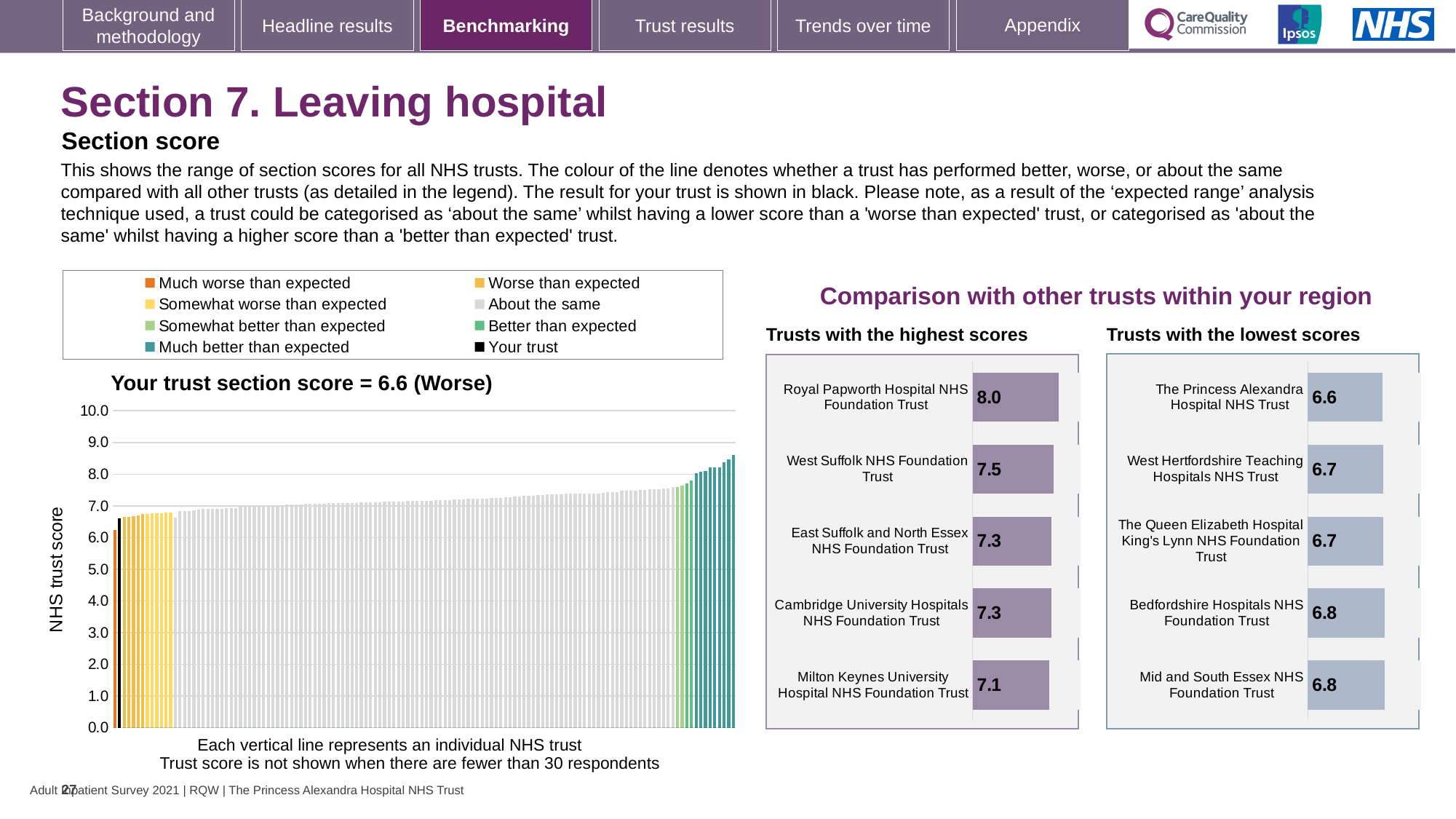
How many entries does the legend above the 'Your trust section score' chart list? 8 In the chart titled 'Your trust section score = 6.6 (Worse)', is the value of the tallest bar greater or less than 8.0? greater In the 'Trusts with the lowest scores' chart, which trust has the lowest score? The Princess Alexandra Hospital NHS Trust In the 'Trusts with the highest scores' chart, which trust has the highest score? Royal Papworth Hospital NHS Foundation Trust In the chart titled 'Your trust section score = 6.6 (Worse)', what kind of chart is shown? Bar chart In the 'Trusts with the highest scores' chart, what is the score for Royal Papworth Hospital NHS Foundation Trust? 8.0 In the 'Trusts with the lowest scores' chart, which has the larger score: West Hertfordshire Teaching Hospitals NHS Trust or Mid and South Essex NHS Foundation Trust? Mid and South Essex NHS Foundation Trust In the 'Trusts with the lowest scores' chart, what is the score for Bedfordshire Hospitals NHS Foundation Trust? 6.8 In the chart titled 'Your trust section score = 6.6 (Worse)', what is the label on the vertical axis? NHS trust score In the 'Trusts with the highest scores' chart, how many trusts are shown? 5 In the chart titled 'Your trust section score = 6.6 (Worse)', what is the section score for your trust? 6.6 In the 'Trusts with the highest scores' chart, what is the difference between the scores of Royal Papworth Hospital NHS Foundation Trust and Milton Keynes University Hospital NHS Foundation Trust? 0.9